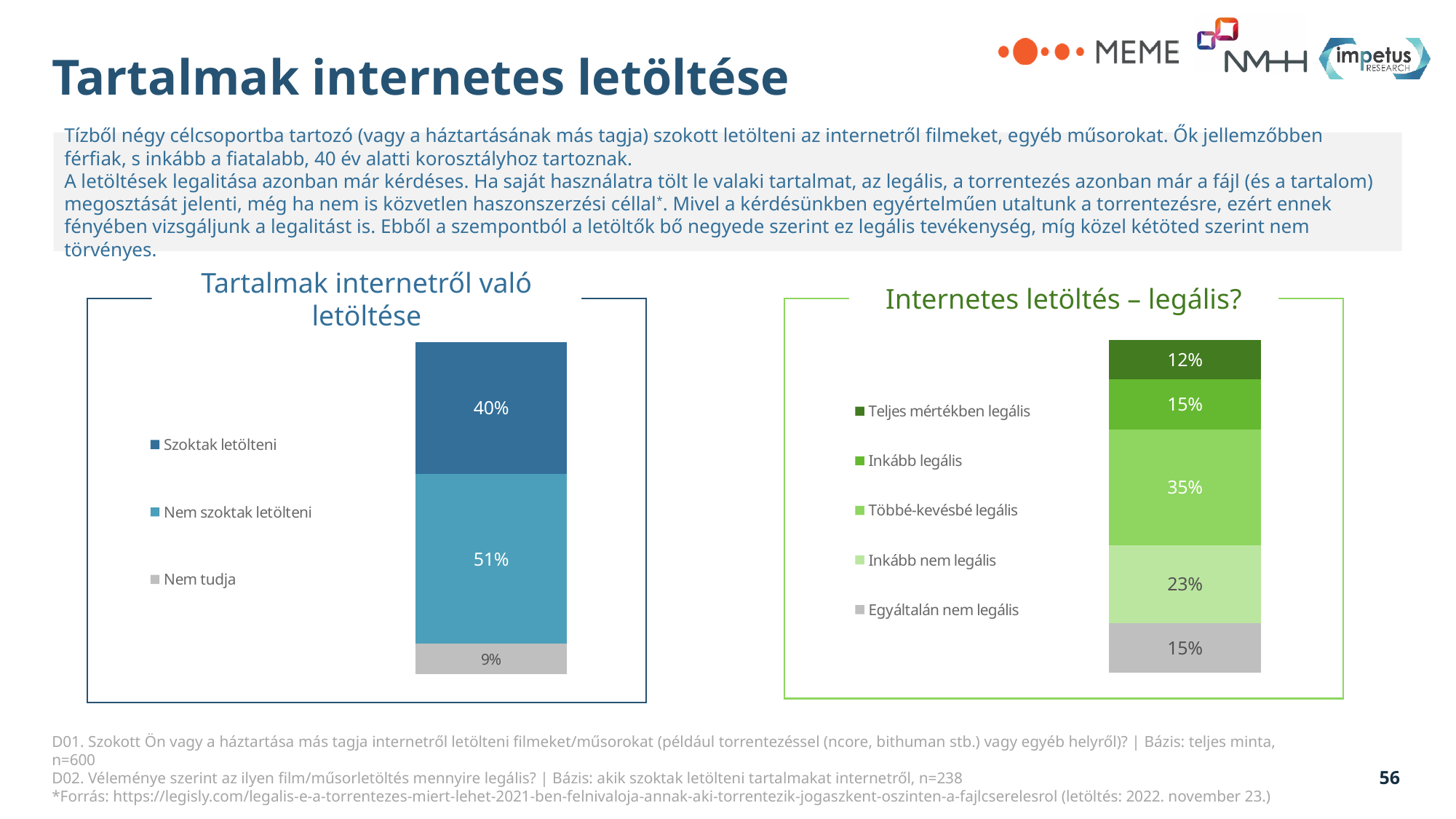
In the chart 'Tartalmak internetről való letöltése', what is the value for 'Nem tudja'? 9% In the chart 'Tartalmak internetről való letöltése', what is the difference between 'Nem szoktak letölteni' and 'Szoktak letölteni'? 11 percentage points In the chart 'Internetes letöltés – legális?', which is larger: 'Inkább nem legális' or 'Inkább legális'? Inkább nem legális In the chart 'Internetes letöltés – legális?', what is the value for 'Többé-kevésbé legális'? 35% In the chart 'Internetes letöltés – legális?', what is the value for 'Inkább nem legális'? 23% What type of chart is 'Internetes letöltés – legális?'? Stacked bar chart In the chart 'Tartalmak internetről való letöltése', what is the value for 'Szoktak letölteni'? 40% In the chart 'Internetes letöltés – legális?', which category has the smallest share? Teljes mértékben legális In the chart 'Internetes letöltés – legális?', what is the value for 'Teljes mértékben legális'? 12% In the chart 'Internetes letöltés – legális?', how many series does the legend list? 5 In the chart 'Tartalmak internetről való letöltése', how many series does the legend list? 3 In the chart 'Tartalmak internetről való letöltése', which category has the largest share? Nem szoktak letölteni